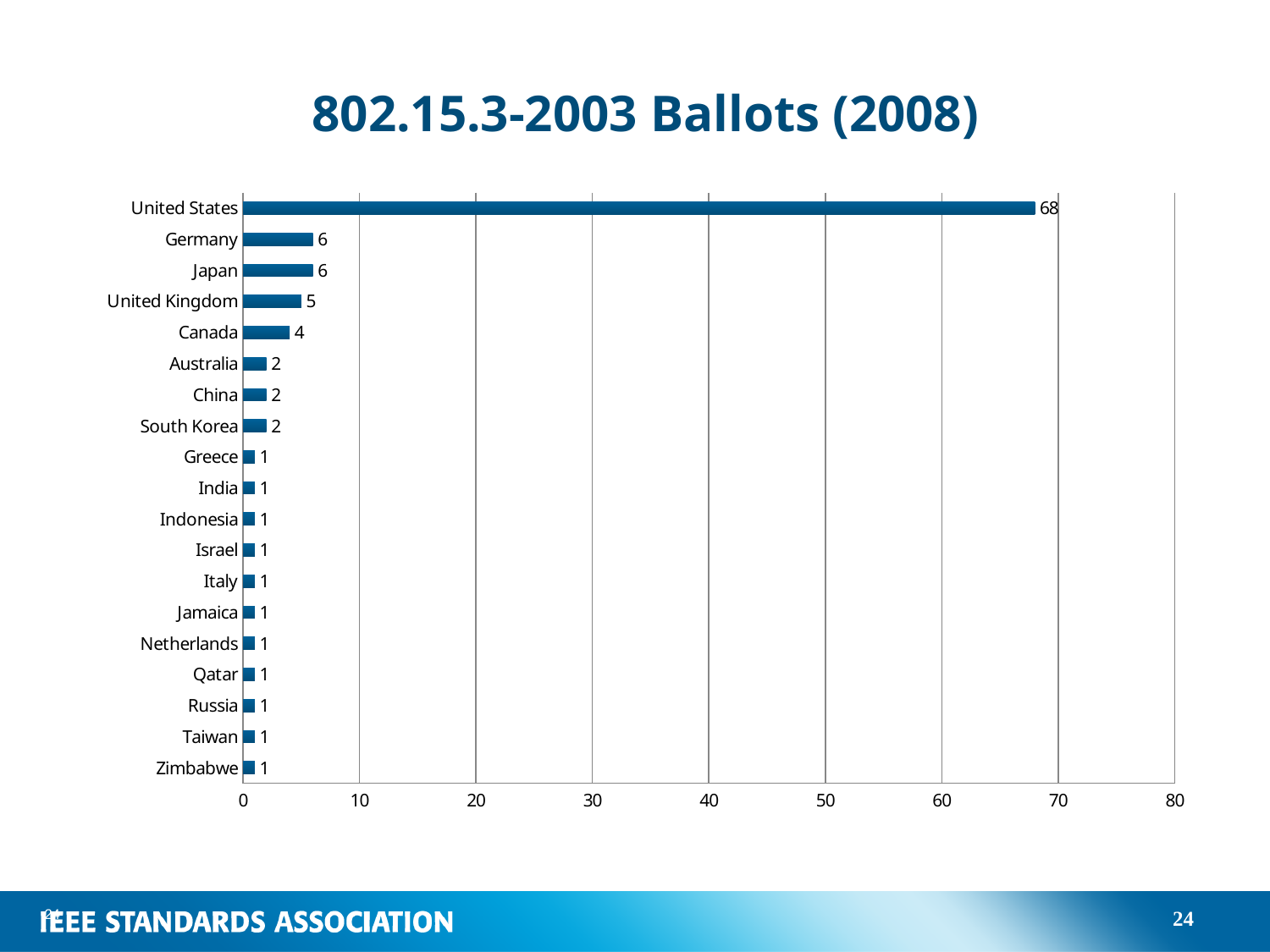
What is the difference between the values for the United States and Germany? 62 Which is larger, the value for Japan or the value for Canada? Japan What is the value for the United Kingdom? 5 What is the value for South Korea? 2 What is the value for the United States? 68 Which country has the highest value? United States What kind of chart is shown on the slide? bar chart What is the value for Canada? 4 What is the title of the chart? 802.15.3-2003 Ballots (2008) What is the difference between the values for the United Kingdom and Australia? 3 How many countries are shown in the chart? 19 Is the value for the United States greater or less than 60? greater